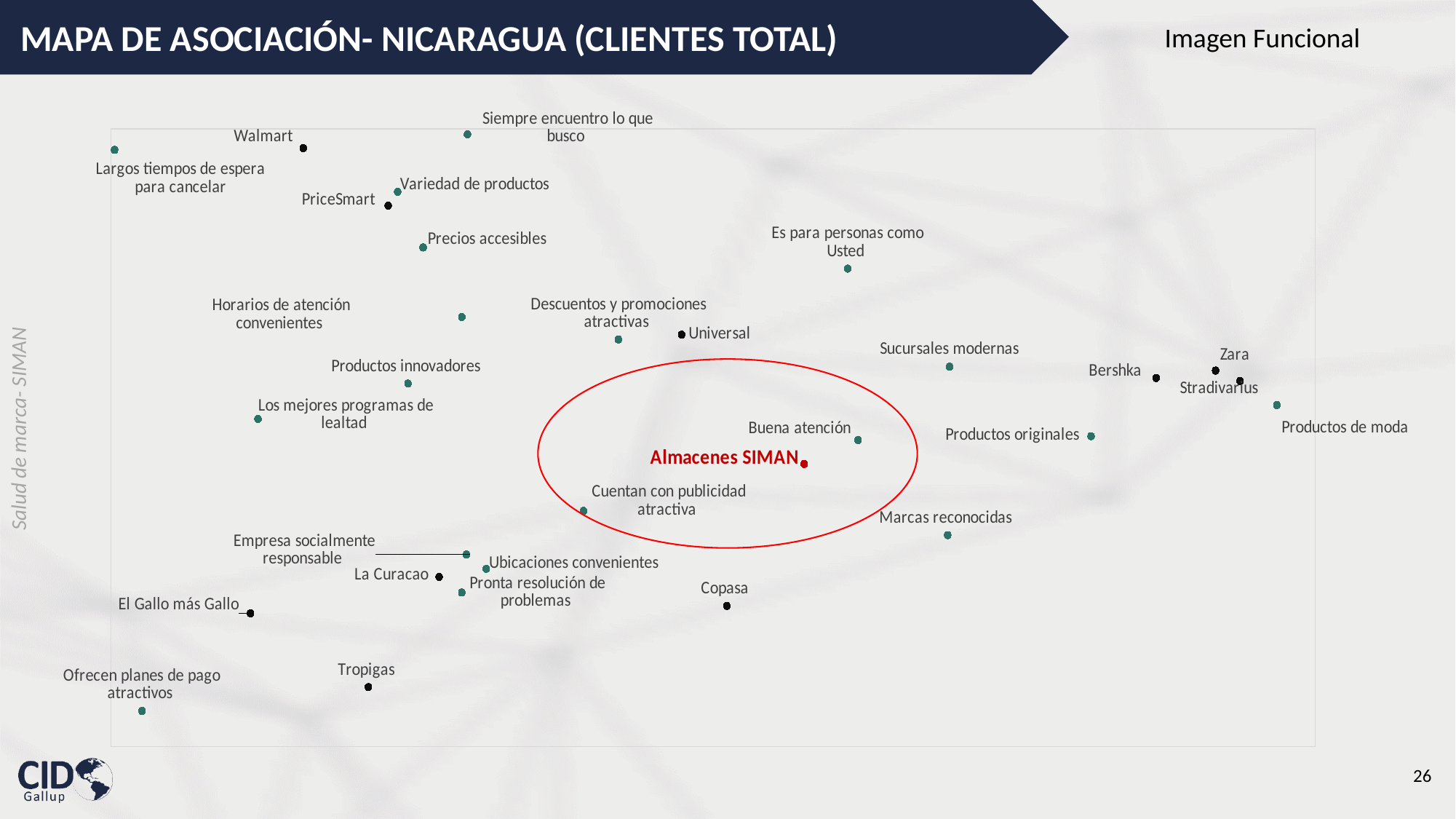
Which brand is highlighted in red and enclosed by the red ellipse? Almacenes SIMAN Which attribute is plotted closest to Walmart? Variedad de productos How many brands (black or red points) are plotted on the map? 11 Which brand is plotted closest to 'Ubicaciones convenientes'? La Curacao Which brand is positioned lowest on the map? Tropigas Which brand is plotted closest to the attribute 'Precios accesibles'? PriceSmart Which brand is plotted closest to the attribute 'Productos de moda'? Stradivarius Which attributes appear inside the red ellipse together with Almacenes SIMAN? Buena atención and Cuentan con publicidad atractiva What kind of chart is shown on the slide? Scatter chart (association map) Which brand is plotted closest to 'Descuentos y promociones atractivas'? Universal Which attribute is positioned in the top-left corner of the map? Largos tiempos de espera para cancelar What is the title of the chart? MAPA DE ASOCIACIÓN- NICARAGUA (CLIENTES TOTAL)